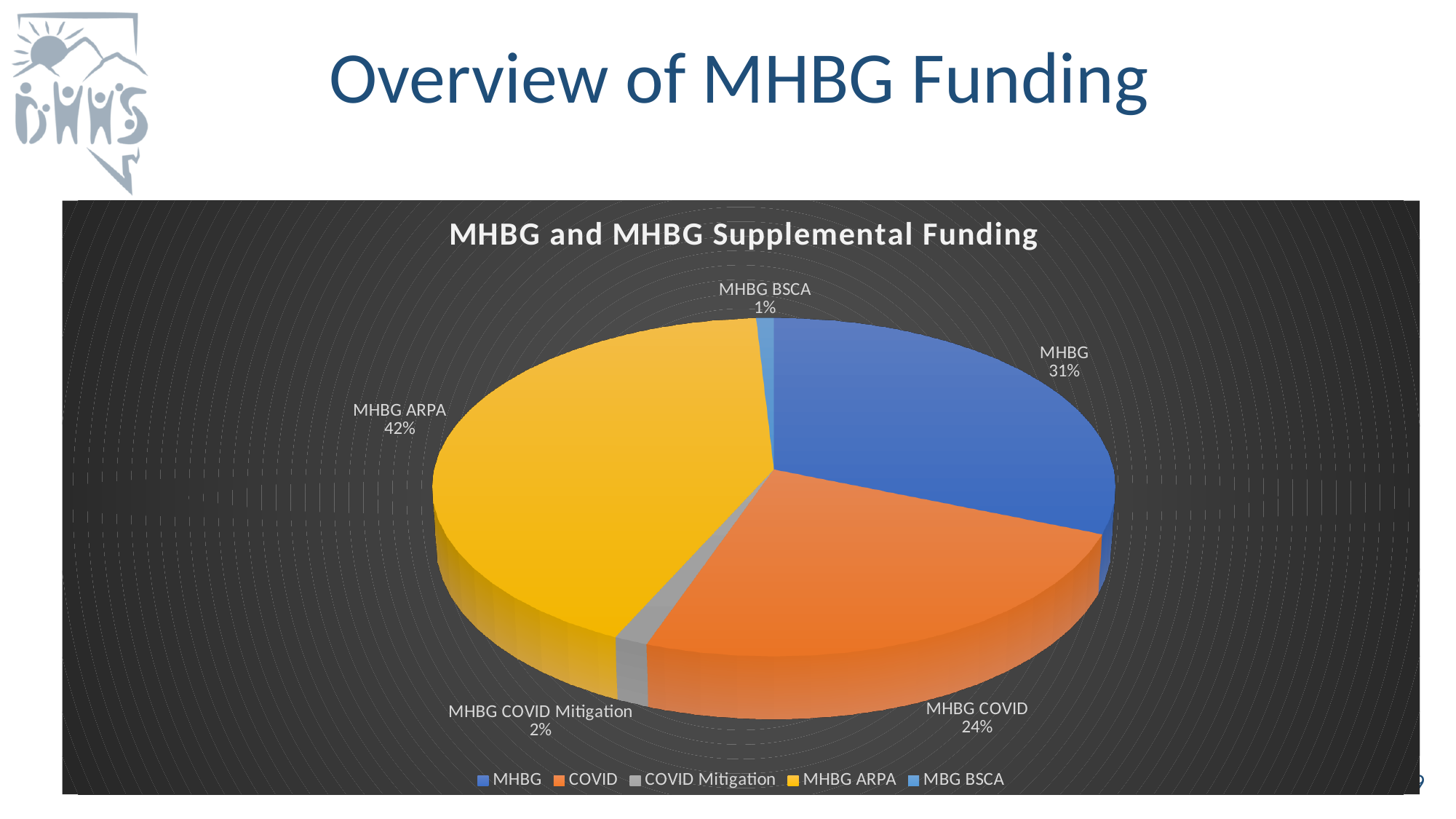
What type of chart is shown on the slide? Pie chart Which slice of the pie is the smallest? MHBG BSCA What percentage is shown for MHBG COVID? 24% What is the difference in percentage points between MHBG ARPA and MHBG? 11 What percentage is shown for MHBG BSCA? 1% What share of the pie does MHBG ARPA represent? 42% How many slices does the pie chart have? 5 Which slice of the pie is the largest? MHBG ARPA What is the title of the chart? MHBG and MHBG Supplemental Funding What percentage is shown for MHBG COVID Mitigation? 2% Which is larger, the MHBG slice or the MHBG COVID slice? MHBG What percentage is shown for MHBG? 31%